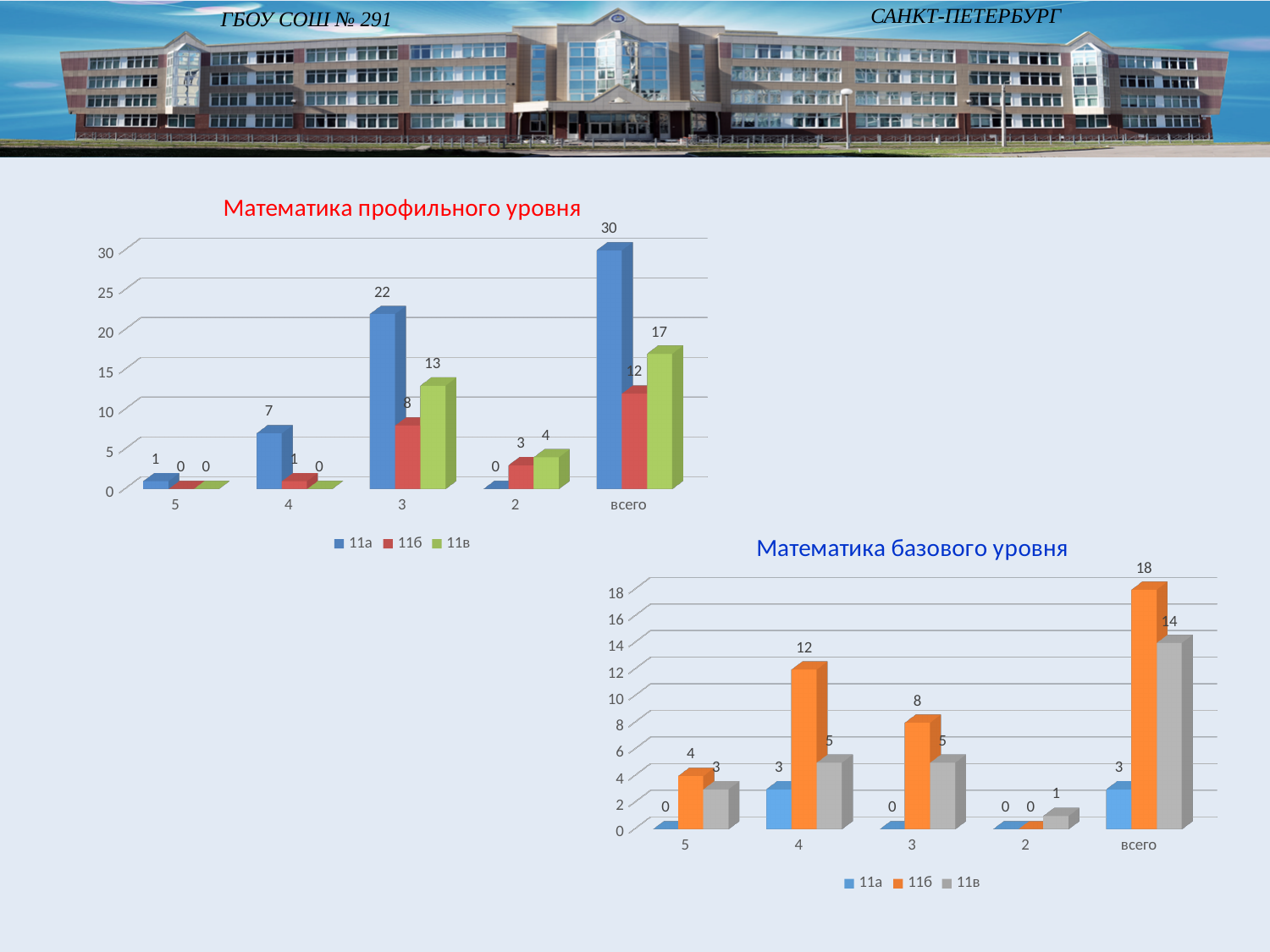
In the chart 'Математика профильного уровня', what is the value for 11а in category 3? 22 How many categories are shown on the x axis of the chart 'Математика базового уровня'? 5 In the chart 'Математика базового уровня', which series has the lowest value in category 'всего'? 11а In the chart 'Математика профильного уровня', which series has the highest value in category 'всего'? 11а What type of chart is 'Математика профильного уровня'? bar chart In the chart 'Математика профильного уровня', how many series does the legend list? 3 In the chart 'Математика профильного уровня', what is the value for 11в in category 'всего'? 17 In the chart 'Математика профильного уровня', what is the difference between 11а and 11б in category 'всего'? 18 In the chart 'Математика базового уровня', what is the value for 11в in category 2? 1 In the chart 'Математика базового уровня', what is the difference between 11б and 11в in category 'всего'? 4 In the chart 'Математика базового уровня', which is larger: 11б in category 3 or 11в in category 3? 11б In the chart 'Математика базового уровня', what is the value for 11б in category 4? 12